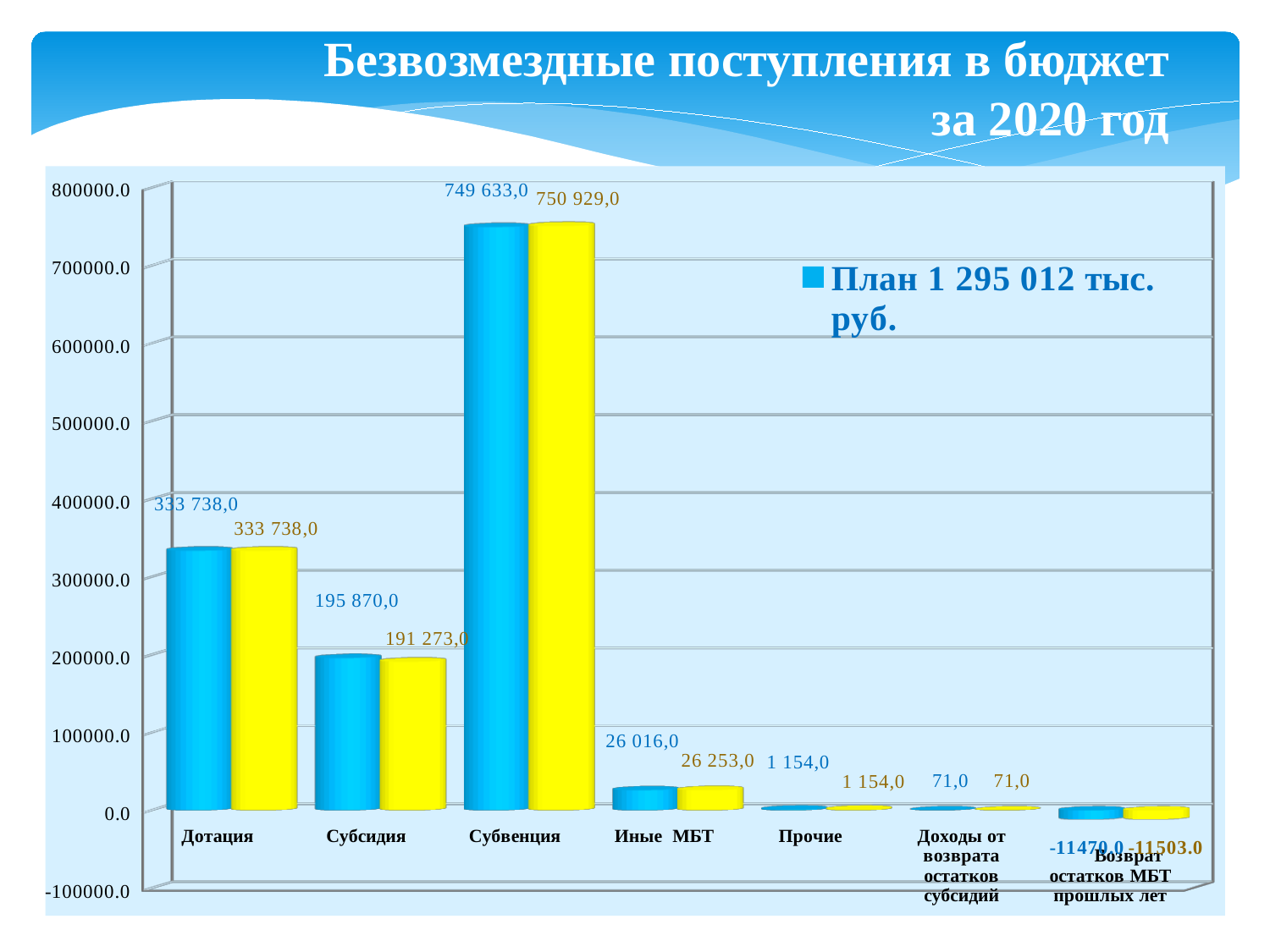
Which category has the highest values on the chart? Субвенция Is the План value for Субвенция greater or less than 700000? greater What is the План (blue bar) value for Дотация? 333 738,0 What is the difference between the yellow bar and the blue bar for Субвенция? 1 296,0 How many categories are shown on the x axis of the chart? 7 What is the difference between the blue bar and the yellow bar for Субсидия? 4 597,0 What kind of chart is shown on the slide? bar chart What is the value of the yellow bar for Субвенция? 750 929,0 Which category has the lowest values on the chart? Возврат остатков МБТ прошлых лет What is the value of the yellow bar for Иные МБТ? 26 253,0 What is the План (blue bar) value for Субсидия? 195 870,0 Which has the larger План (blue bar) value, Дотация or Субсидия? Дотация